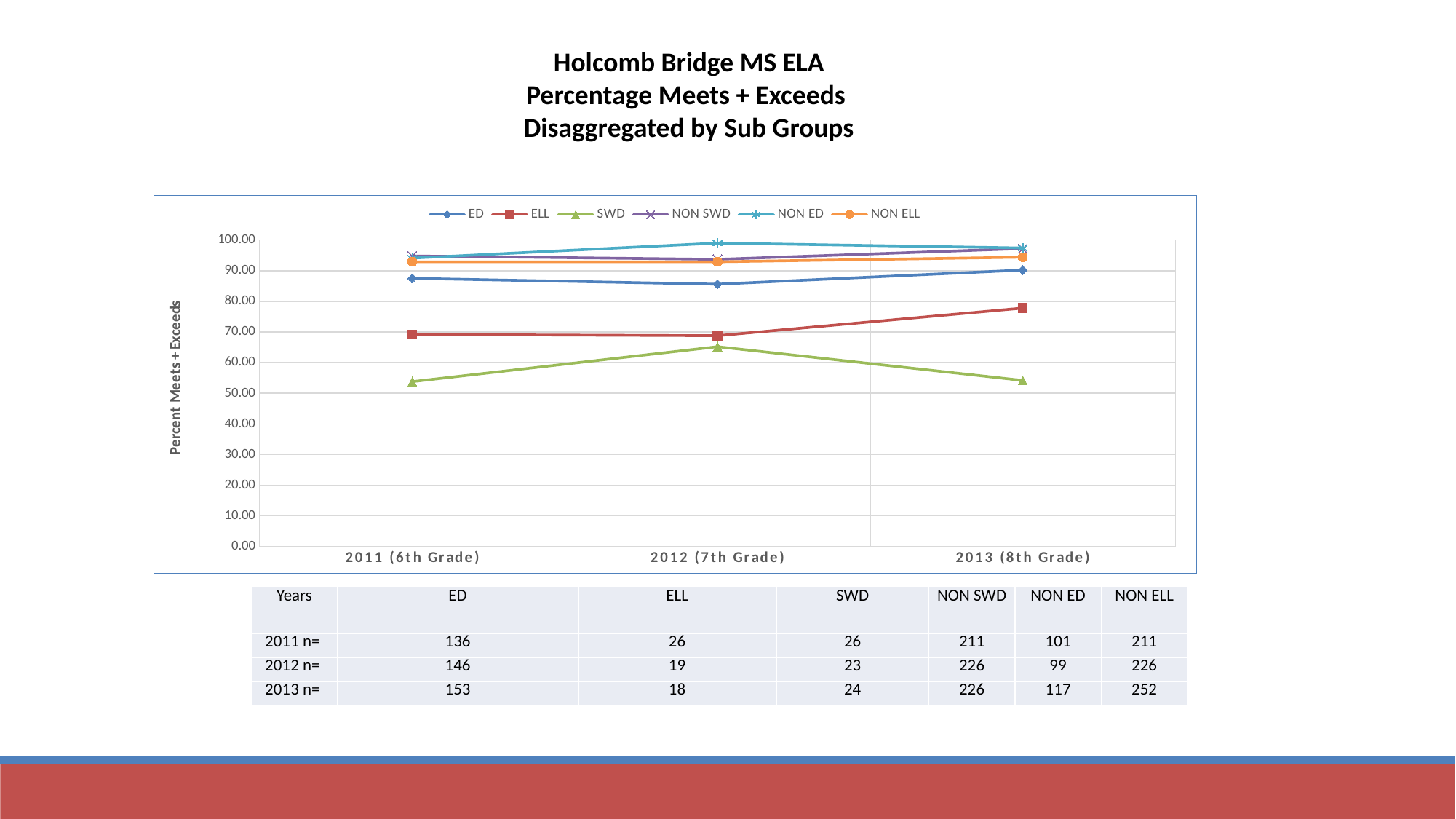
How many series does the legend list? 6 Is the value for ELL in 2013 (8th Grade) greater or less than 70.00? greater Is the value for SWD in 2011 (6th Grade) greater or less than 60.00? less What kind of chart is shown on the slide? line chart Which is larger for SWD, the value in 2011 (6th Grade) or the value in 2012 (7th Grade)? 2012 (7th Grade) What is the title of the y axis? Percent Meets + Exceeds How many points are shown along the x axis? 3 Which is larger in 2013 (8th Grade), the value for ED or the value for ELL? ED Which sub group has the lowest value in 2011 (6th Grade)? SWD Does the ELL line rise or fall from 2012 (7th Grade) to 2013 (8th Grade)? rise Is the value for ED in 2012 (7th Grade) greater or less than 80.00? greater Which sub group has the highest value in 2012 (7th Grade)? NON ED